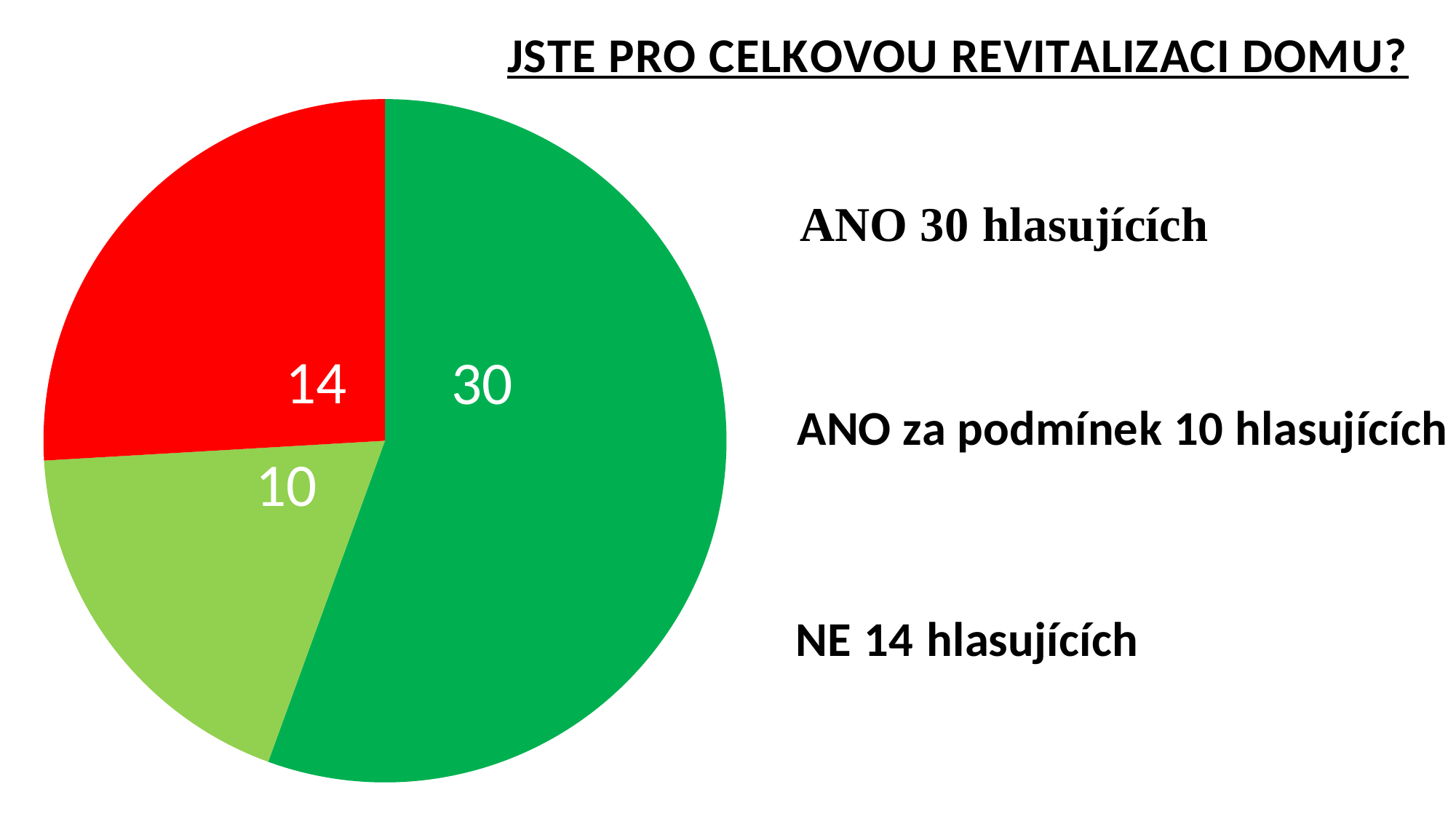
What is the total number of votes shown in the pie chart? 54 What colour is the slice representing NE? red What kind of chart is shown on the slide? pie chart Which answer received the fewest votes? ANO za podmínek Which answer received the most votes? ANO What is the difference between the ANO votes and the NE votes? 16 How many voters answered ANO? 30 How many voters answered ANO za podmínek? 10 Which received more votes, NE or ANO za podmínek? NE How many slices does the pie chart have? 3 What is the title of the chart? JSTE PRO CELKOVOU REVITALIZACI DOMU? How many voters answered NE? 14